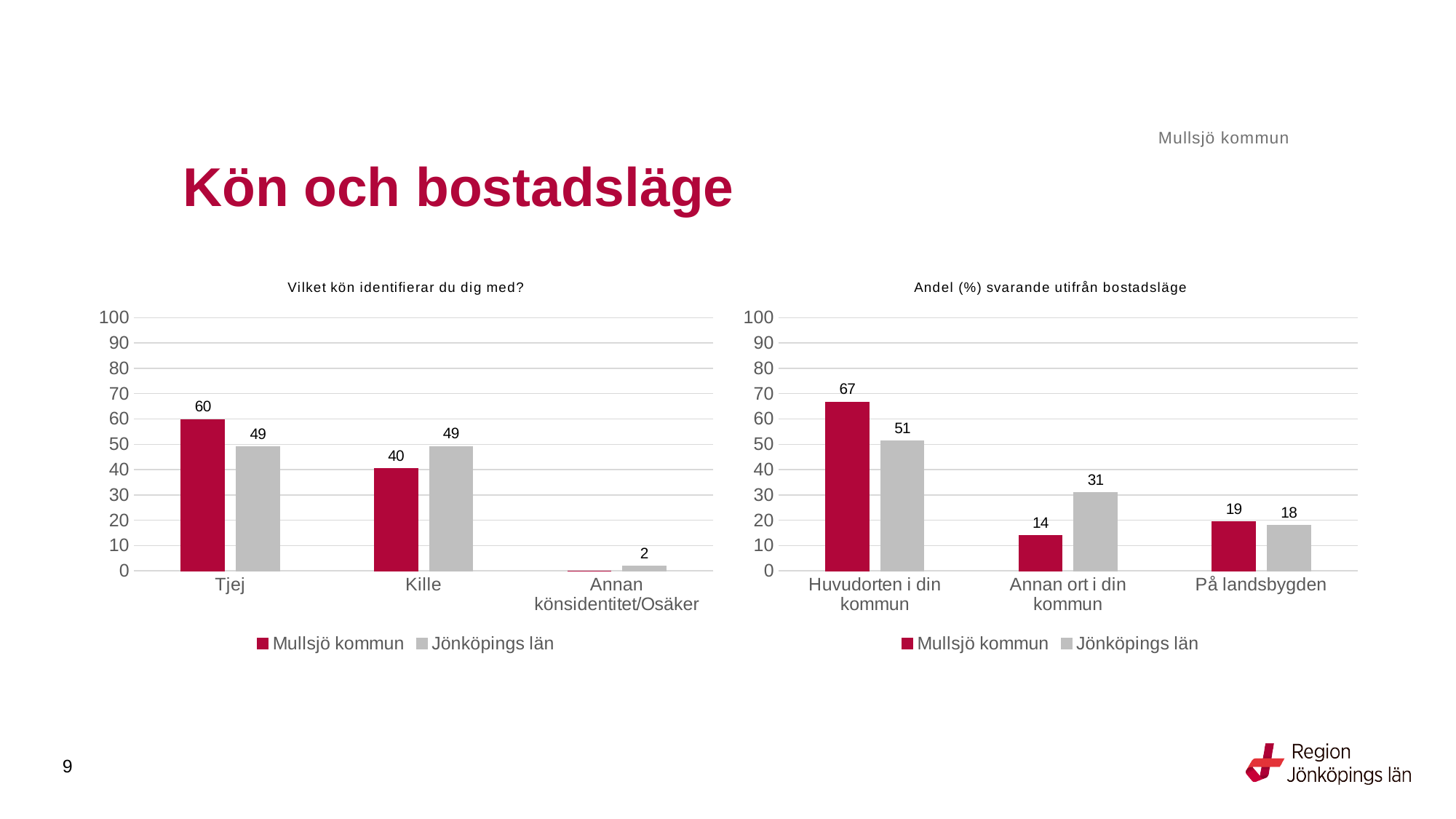
In the chart 'Vilket kön identifierar du dig med?', which category has the lowest value for Jönköpings län? Annan könsidentitet/Osäker In the chart 'Andel (%) svarande utifrån bostadsläge', how many series does the legend list? 2 In the chart 'Andel (%) svarande utifrån bostadsläge', what is the value for Jönköpings län for Annan ort i din kommun? 31 In the chart 'Vilket kön identifierar du dig med?', what is the difference between the Mullsjö kommun and Jönköpings län values for Tjej? 11 In the chart 'Andel (%) svarande utifrån bostadsläge', which category has the highest value for Mullsjö kommun? Huvudorten i din kommun In the chart 'Vilket kön identifierar du dig med?', how many categories are shown on the x axis? 3 In the chart 'Andel (%) svarande utifrån bostadsläge', which is larger for Annan ort i din kommun: Mullsjö kommun or Jönköpings län? Jönköpings län In the chart 'Vilket kön identifierar du dig med?', what is the value for Jönköpings län for Kille? 49 In the chart 'Andel (%) svarande utifrån bostadsläge', what is the value for Mullsjö kommun for Huvudorten i din kommun? 67 In the chart 'Vilket kön identifierar du dig med?', what is the value for Mullsjö kommun for Tjej? 60 In the chart 'Andel (%) svarande utifrån bostadsläge', what is the difference between the Mullsjö kommun and Jönköpings län values for Huvudorten i din kommun? 16 What kind of chart is 'Andel (%) svarande utifrån bostadsläge'? Bar chart